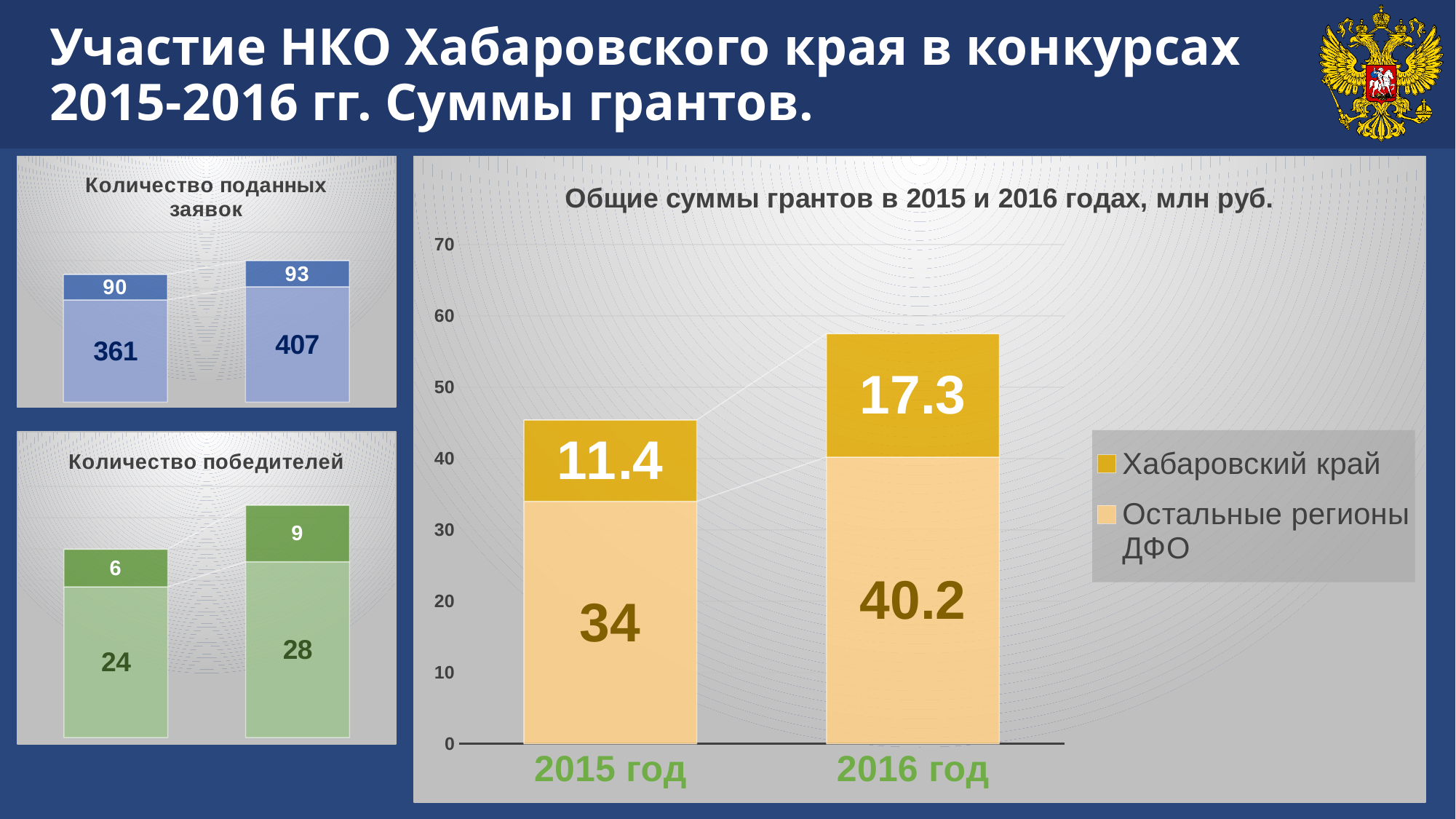
In the chart 'Количество победителей' on the left, what is the total of the left stacked bar? 30 In the chart 'Общие суммы грантов в 2015 и 2016 годах, млн руб.', which year has the larger value for Остальные регионы ДФО? 2016 год What kind of chart is 'Общие суммы грантов в 2015 и 2016 годах, млн руб.'? stacked bar chart In the chart 'Общие суммы грантов в 2015 и 2016 годах, млн руб.', what is the value for Остальные регионы ДФО in 2016 год? 40.2 In the chart 'Общие суммы грантов в 2015 и 2016 годах, млн руб.', what is the total of the stacked bar for 2015 год? 45.4 In the chart 'Общие суммы грантов в 2015 и 2016 годах, млн руб.', what is the value for Хабаровский край in 2015 год? 11.4 In the chart 'Количество поданных заявок' on the left, what is the total of the right stacked bar? 500 In the chart 'Общие суммы грантов в 2015 и 2016 годах, млн руб.', how many series does the legend list? 2 In the chart 'Общие суммы грантов в 2015 и 2016 годах, млн руб.', which colour represents Хабаровский край? dark yellow (gold) In the chart 'Общие суммы грантов в 2015 и 2016 годах, млн руб.', do the values for Хабаровский край rise or fall from 2015 год to 2016 год? rise In the chart 'Общие суммы грантов в 2015 и 2016 годах, млн руб.', by how much did the value for Хабаровский край increase from 2015 год to 2016 год? 5.9